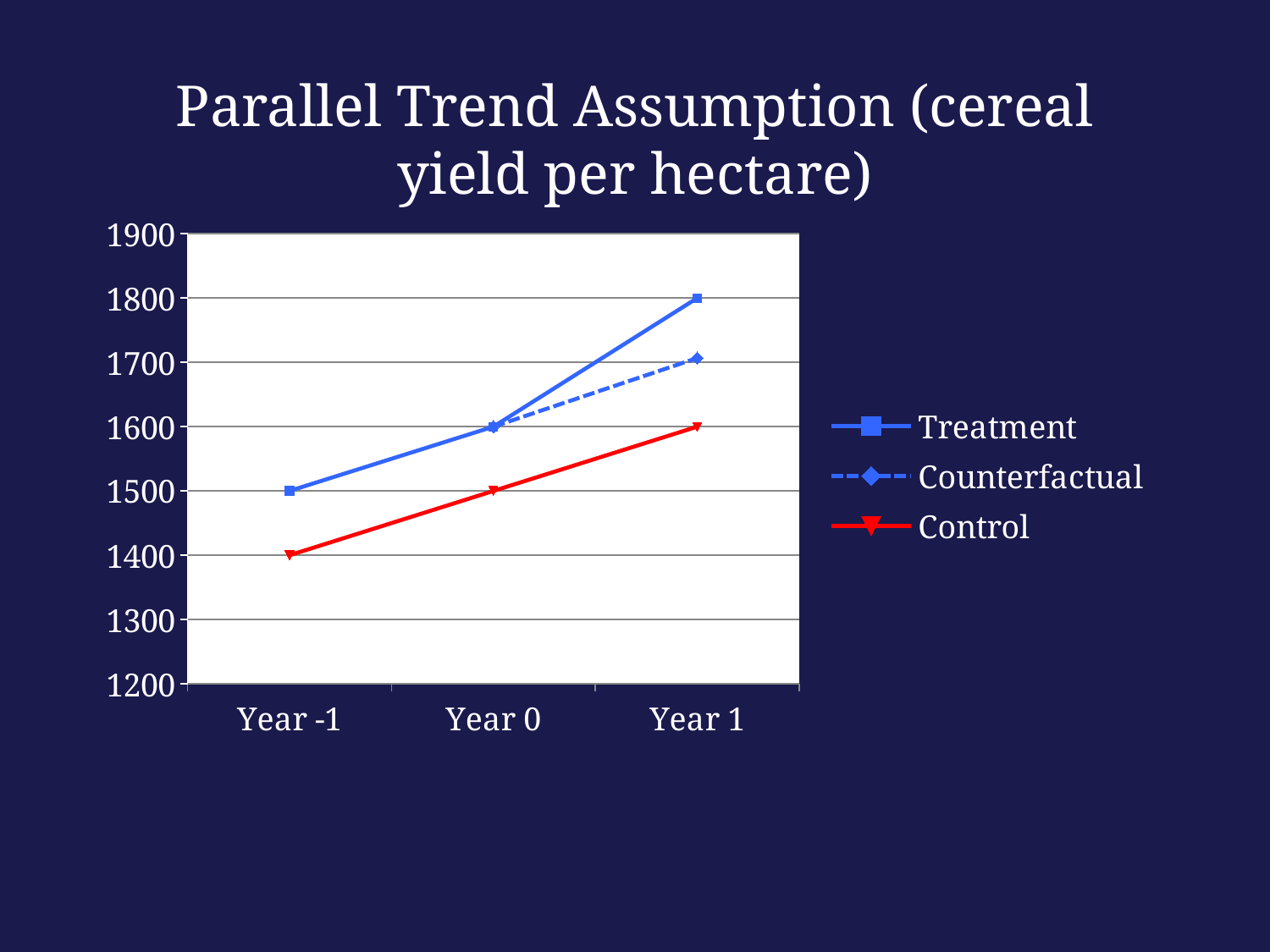
What is the difference between the Treatment and Control values at Year 1? 200 Which series has the highest value at Year 1? Treatment Which series has the lowest value at Year 0? Control What is the Control value at Year 1? 1600 Which series is drawn with a dashed line? Counterfactual What is the Treatment value at Year -1? 1500 Does the Control series rise or fall from Year -1 to Year 1? rise How many series does the legend list? 3 What kind of chart is shown on the slide? line chart What is the Control value at Year -1? 1400 What is the Treatment value at Year 1? 1800 How many points are on the x axis? 3